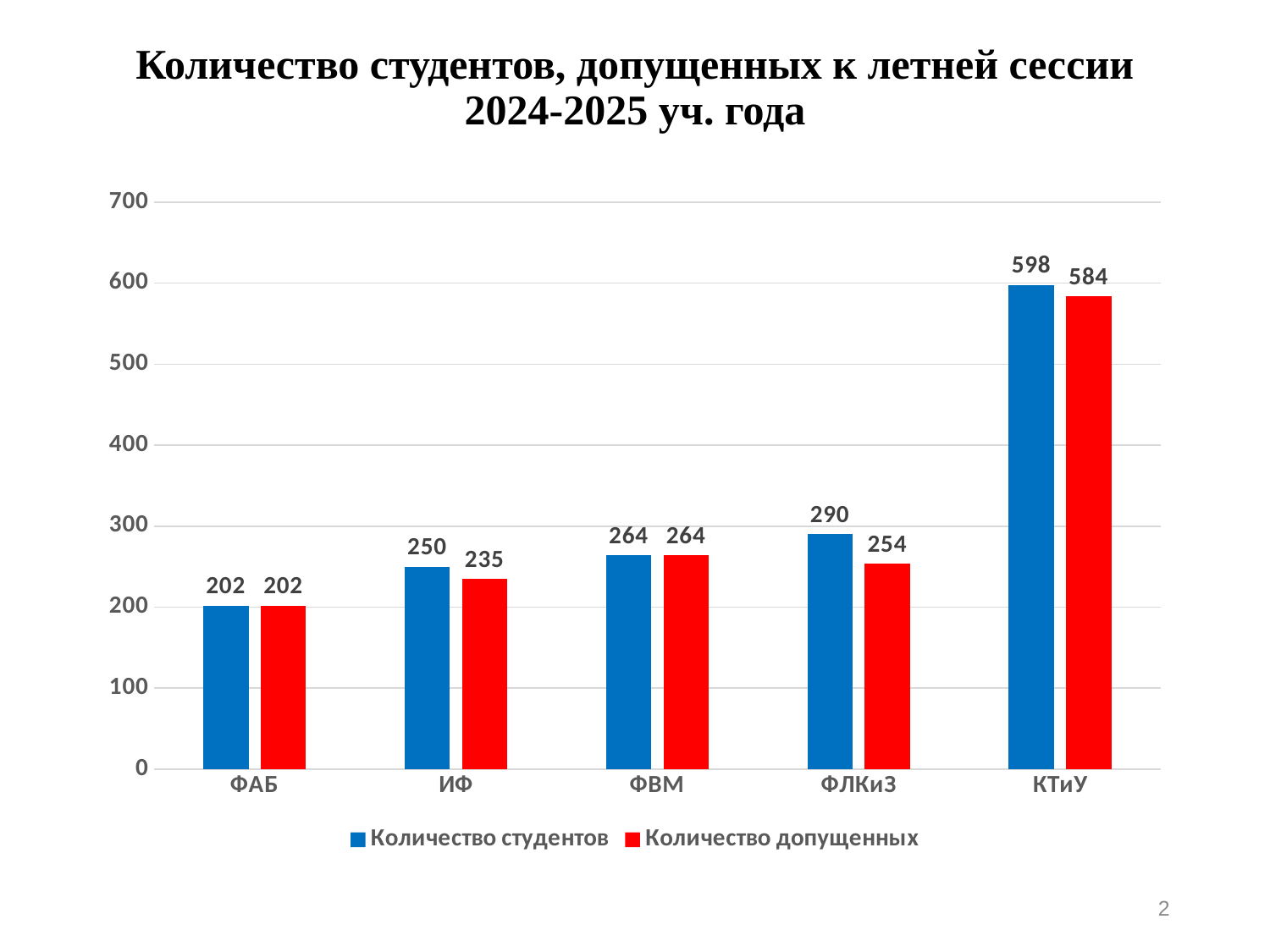
What is the value of Количество студентов for КТиУ? 598 What is the value of Количество допущенных for ИФ? 235 How many series does the legend list? 2 What is the difference between Количество студентов and Количество допущенных for КТиУ? 14 How many categories are shown on the x axis? 5 What kind of chart is shown on the slide? Bar chart What is the value of Количество допущенных for ФЛКиЗ? 254 Which category has the lowest value for Количество допущенных? ФАБ What colour are the bars for Количество допущенных? Red Which is larger: Количество студентов for ФВМ or Количество студентов for ИФ? ФВМ Which category has the highest value for Количество студентов? КТиУ What is the difference between Количество студентов and Количество допущенных for ФЛКиЗ? 36